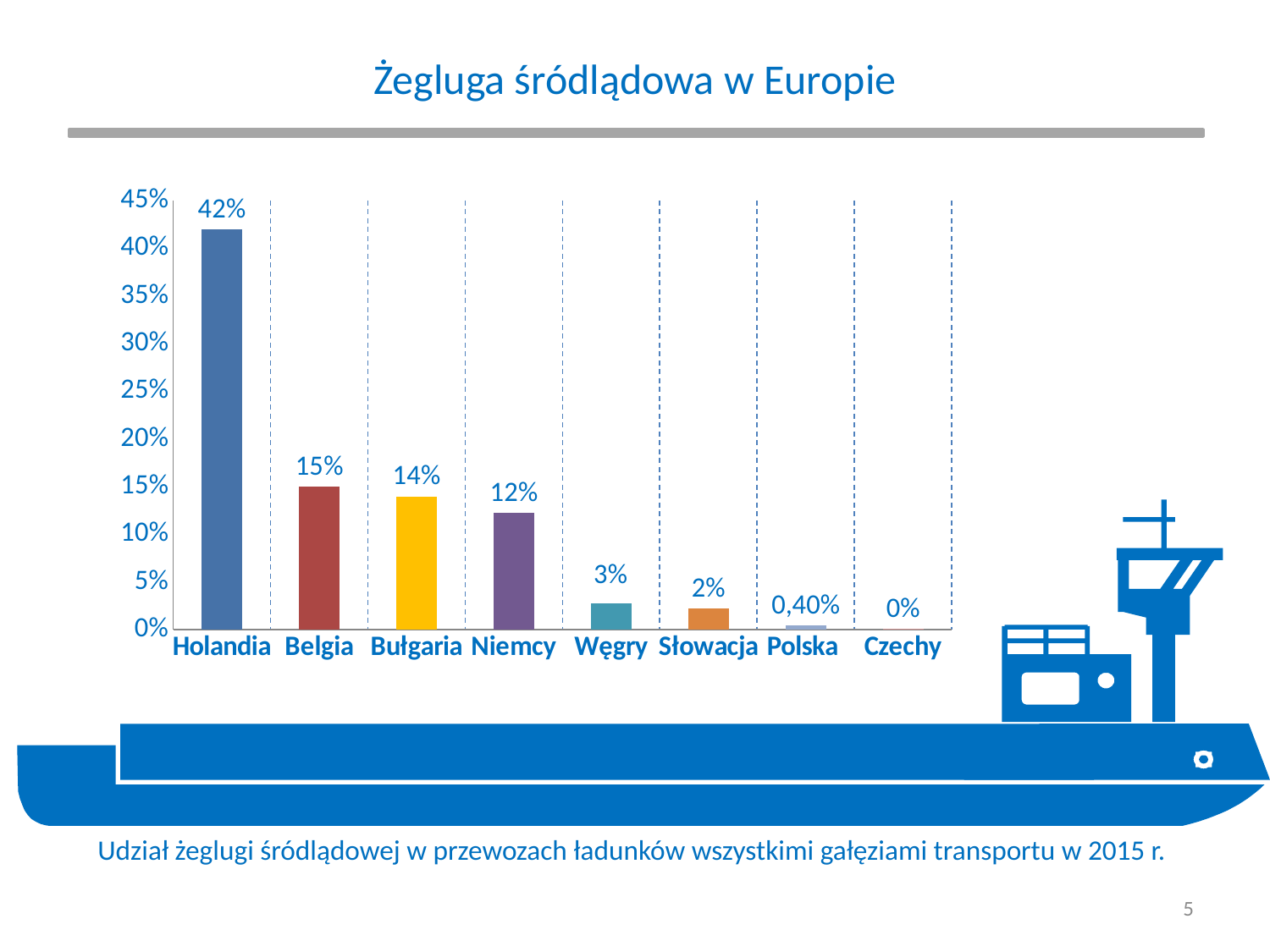
What is the value for Polska? 0,40% What is the value for Niemcy? 12% What is the title of the slide containing the chart? Żegluga śródlądowa w Europie What kind of chart is shown on the slide? bar chart Which is larger, the value for Bułgaria or the value for Niemcy? Bułgaria Do the values rise or fall from left to right along the x axis? fall Which country has the highest value? Holandia What is the difference between the values for Holandia and Belgia? 27% Which country has the lowest value? Czechy Is the value for Holandia greater or less than 40%? greater How many countries are shown on the chart? 8 What is the value for Holandia? 42%